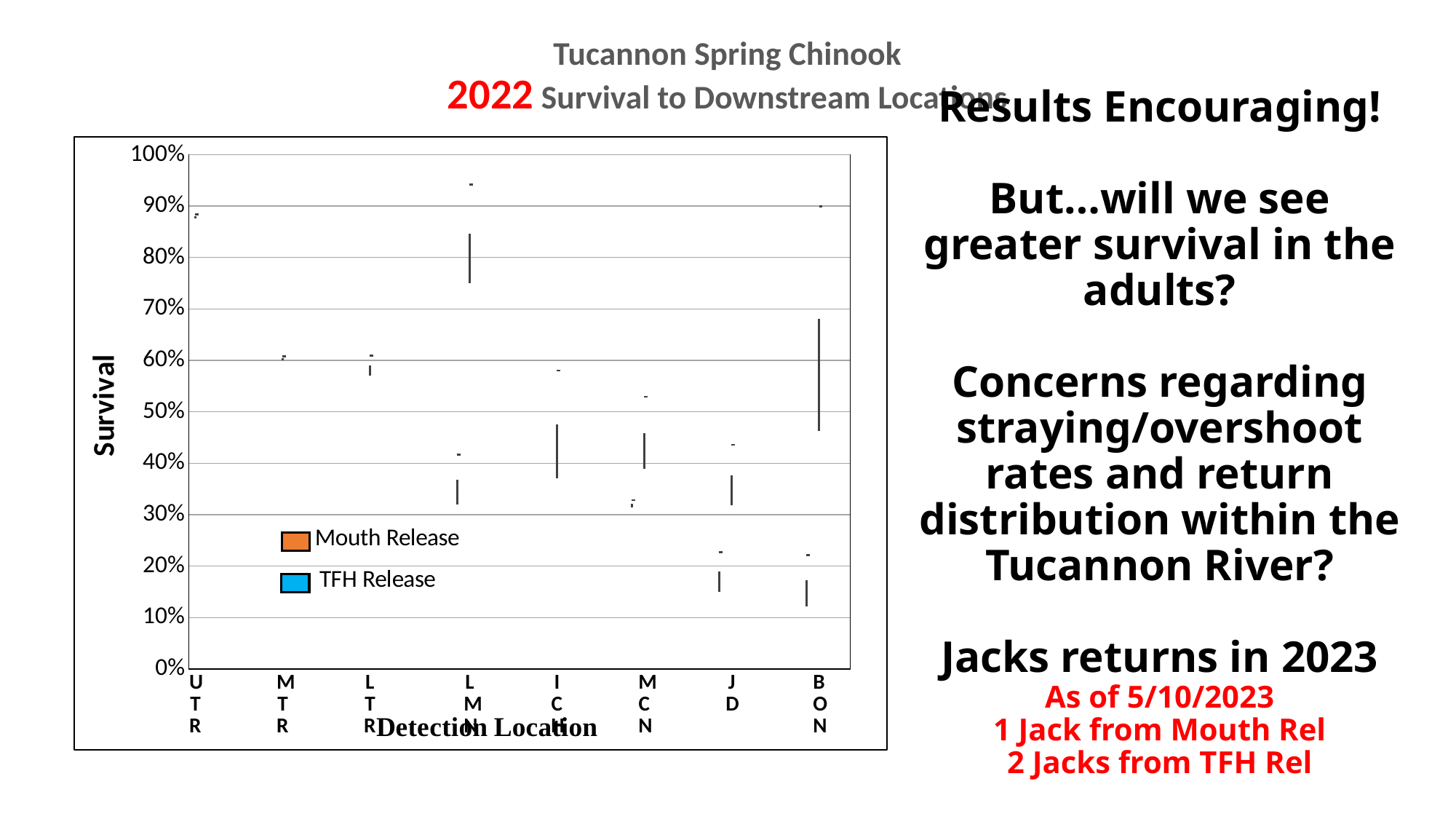
Is the highest plotted survival value at LMN greater or less than 70%? greater Is the lowest plotted survival value at MCN greater or less than 40%? less Is the survival value plotted for UTR greater or less than 80%? greater What are the two series named in the chart's legend? Mouth Release and TFH Release How many series does the chart's legend list? 2 What is the title of the chart's y axis? Survival Is the survival value plotted for UTR greater or less than the lowest value plotted for BON? greater How many detection locations are shown on the x axis of the chart? 8 What is the maximum value shown on the chart's y axis? 100%